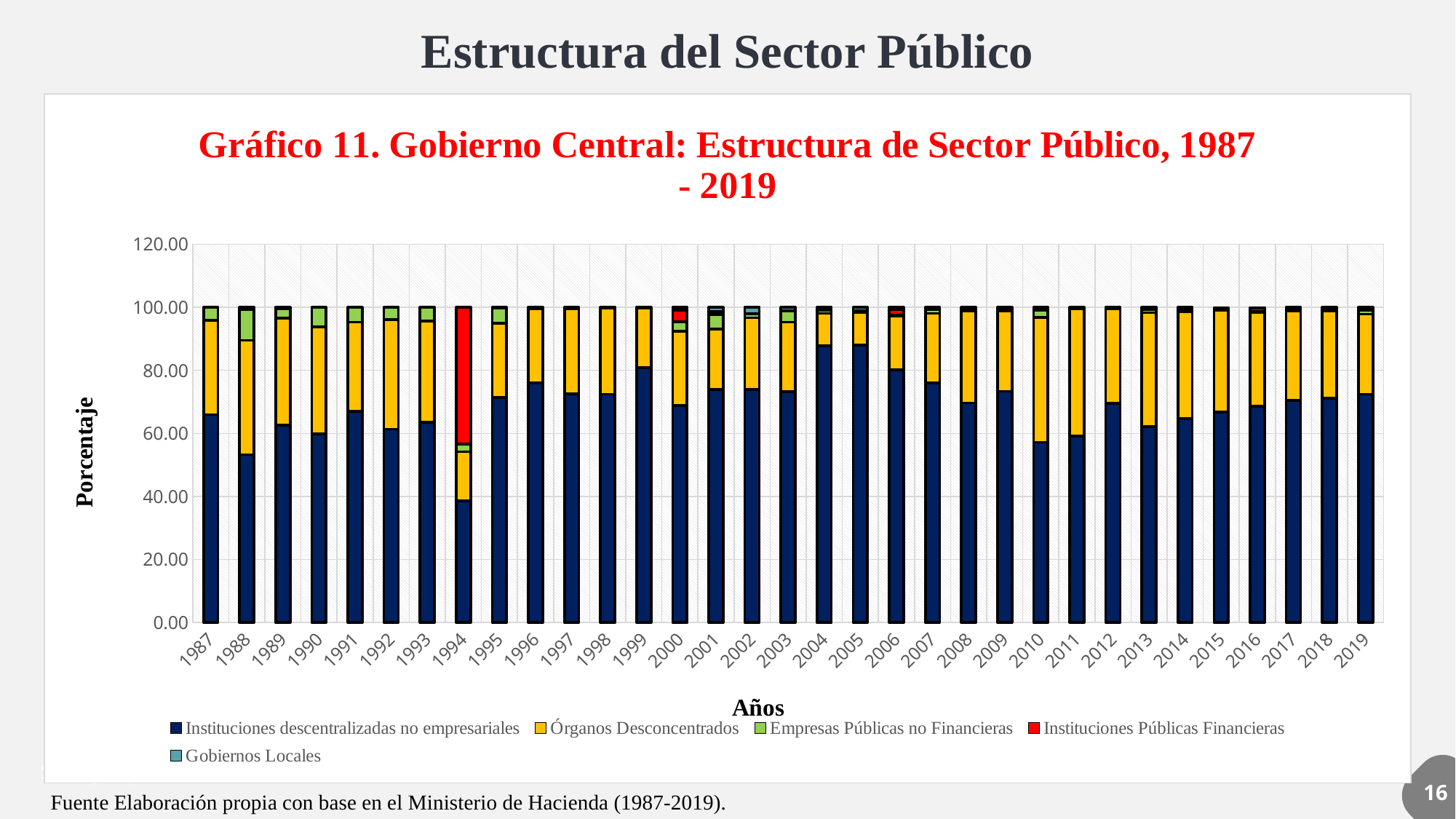
What is the title of the chart? Gráfico 11. Gobierno Central: Estructura de Sector Público, 1987 - 2019 Is the value for Instituciones descentralizadas no empresariales in 1988 greater or less than 60? less Which series is shown in red in the legend? Instituciones Públicas Financieras What kind of chart is shown on the slide? Stacked bar chart Which year has the larger Instituciones descentralizadas no empresariales segment, 1994 or 1995? 1995 In which year is the Instituciones Públicas Financieras segment the largest? 1994 Which year has the larger Empresas Públicas no Financieras segment, 1988 or 1996? 1988 In which year is the Instituciones descentralizadas no empresariales segment the smallest? 1994 How many series does the legend list? 5 How many years are shown on the x axis? 33 Is the value for Instituciones descentralizadas no empresariales in 2004 greater or less than 80? greater Is the value for Instituciones descentralizadas no empresariales in 1996 greater or less than 60? greater